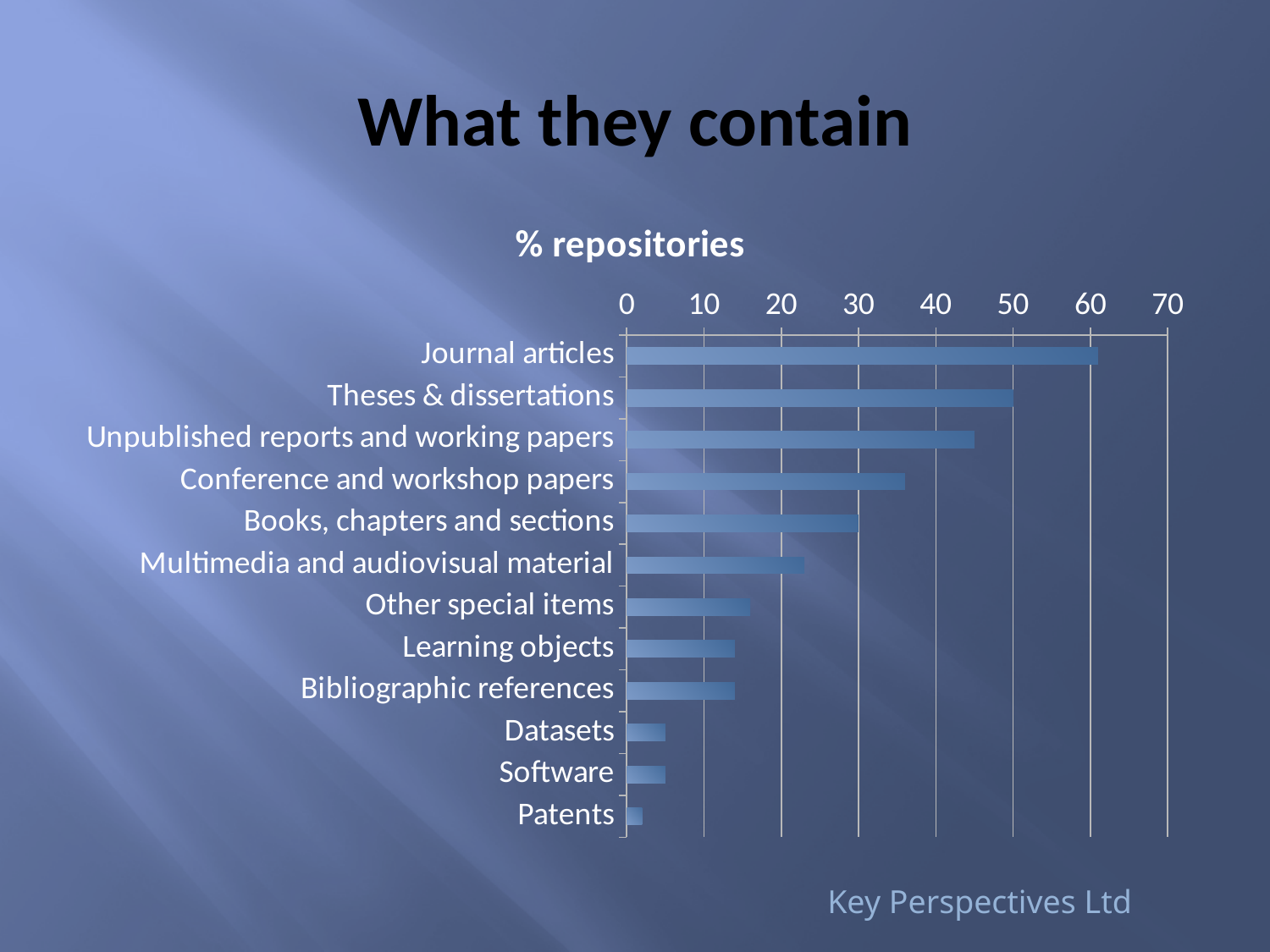
Is the value for Unpublished reports and working papers greater or less than 40? greater Which is larger, the value for Other special items or the value for Software? Other special items Which category has the highest value? Journal articles How many categories are plotted in the chart? 12 Which is larger, the value for Theses & dissertations or the value for Books, chapters and sections? Theses & dissertations Is the value for Journal articles greater or less than 60? greater Which category has the lowest value? Patents Is the value for Conference and workshop papers greater or less than 40? less What is the title of the chart? % repositories What kind of chart is shown on the slide? bar chart